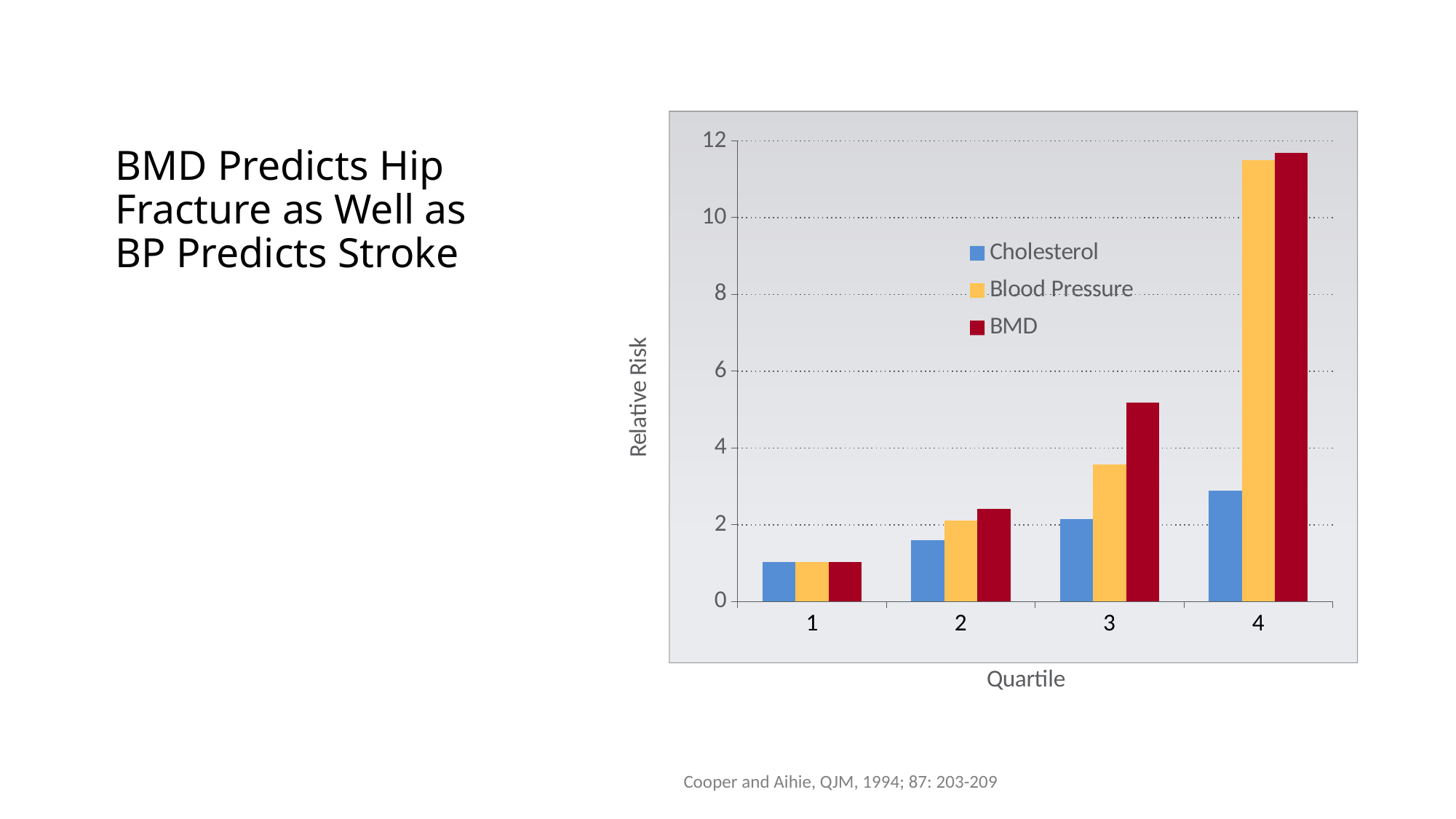
Is the BMD value for quartile 4 greater or less than 10? greater Do the BMD values rise or fall from quartile 1 to quartile 4? rise Which series has the highest relative risk in quartile 3? BMD Is the Blood Pressure value for quartile 2 greater or less than 4? less Is the Cholesterol value for quartile 4 greater or less than 4? less Which is larger in quartile 3, the Blood Pressure value or the Cholesterol value? Blood Pressure What kind of chart is shown on the slide? bar chart Which series has the lowest relative risk in quartile 4? Cholesterol How many quartile categories are shown on the x axis? 4 How many series does the legend list? 3 What is the label of the y axis? Relative Risk